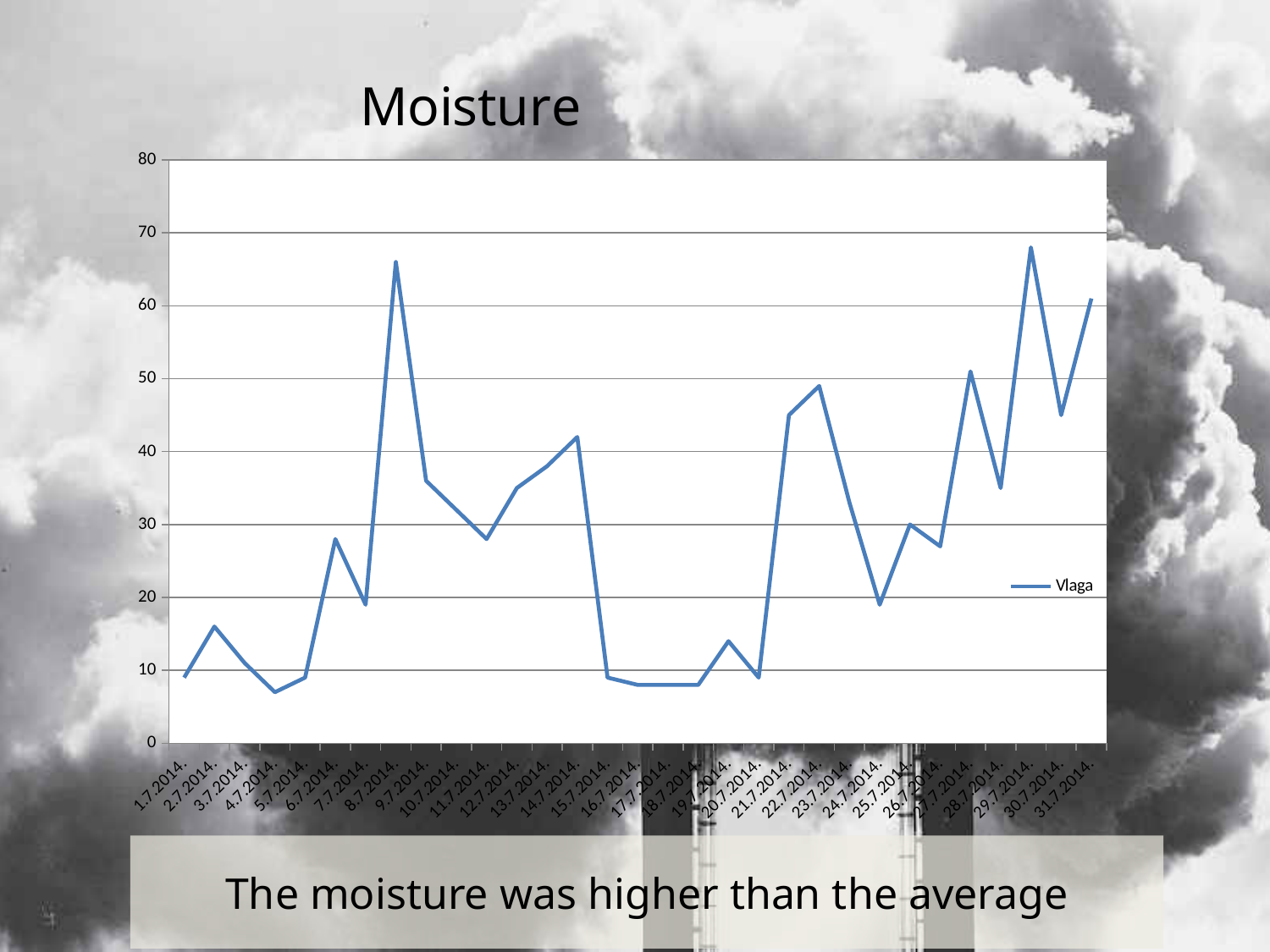
How many dates are plotted along the x axis? 31 Is the value for 4.7.2014. greater or less than 10? less What type of chart is shown on the slide? line chart Which has the higher value, 8.7.2014. or 9.7.2014.? 8.7.2014. Is the value for 22.7.2014. greater or less than 40? greater Is the value for 8.7.2014. greater or less than 60? greater Which has the higher value, 22.7.2014. or 24.7.2014.? 22.7.2014. Between 8.7.2014. and 11.7.2014., does the line rise or fall? fall What series name does the legend show? Vlaga What is the title of the chart? Moisture How many series does the legend list? 1